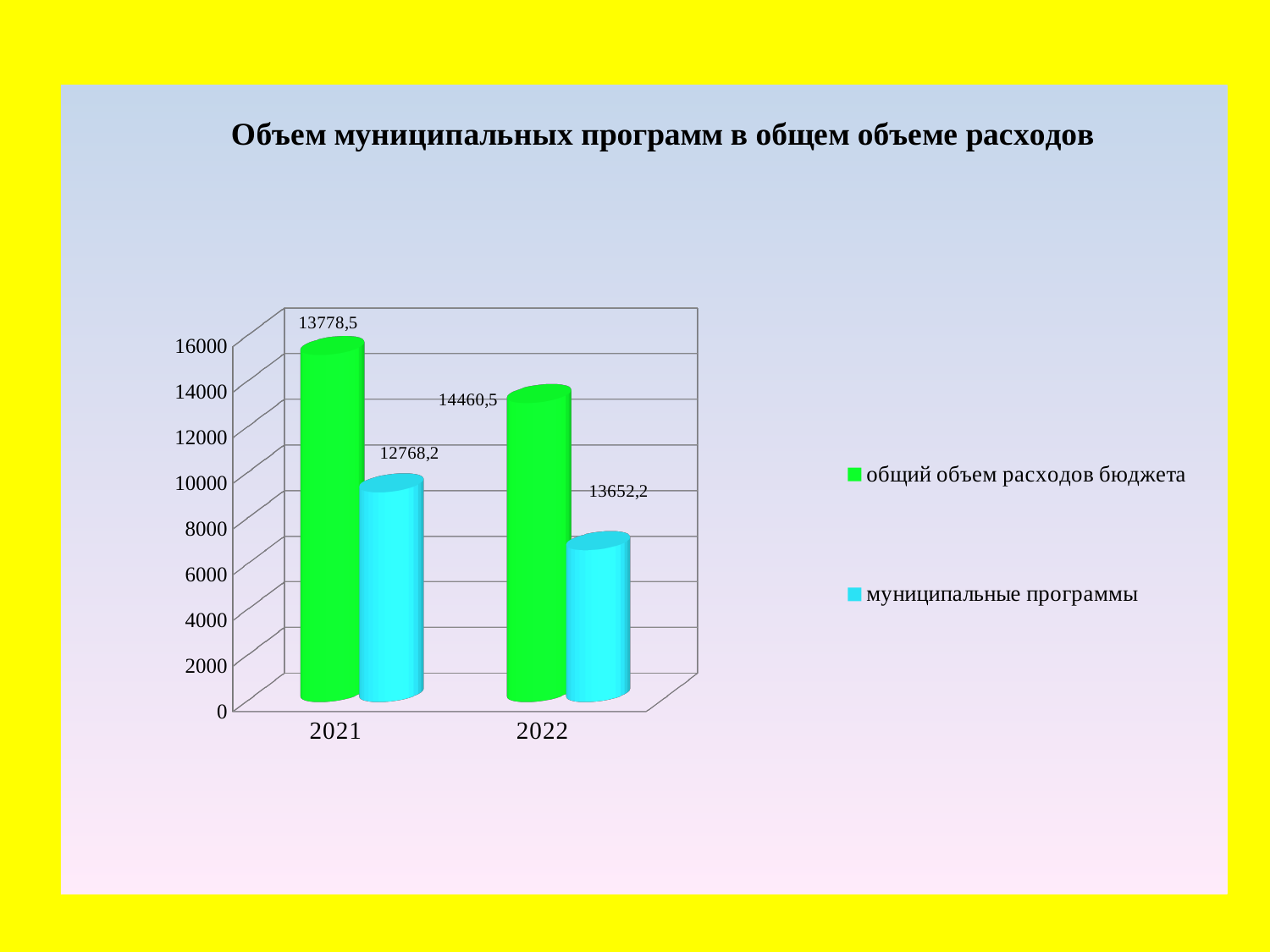
What is the value for общий объем расходов бюджета in 2021? 13778,5 How many years are shown on the x axis? 2 What is the value for муниципальные программы in 2022? 13652,2 What is the value for муниципальные программы in 2021? 12768,2 What kind of chart is shown on the slide? bar chart What is the difference between общий объем расходов бюджета and муниципальные программы in 2022? 808,3 Which is larger in 2022: общий объем расходов бюджета or муниципальные программы? общий объем расходов бюджета What is the value for общий объем расходов бюджета in 2022? 14460,5 How many series does the legend list? 2 What is the difference between общий объем расходов бюджета and муниципальные программы in 2021? 1010,3